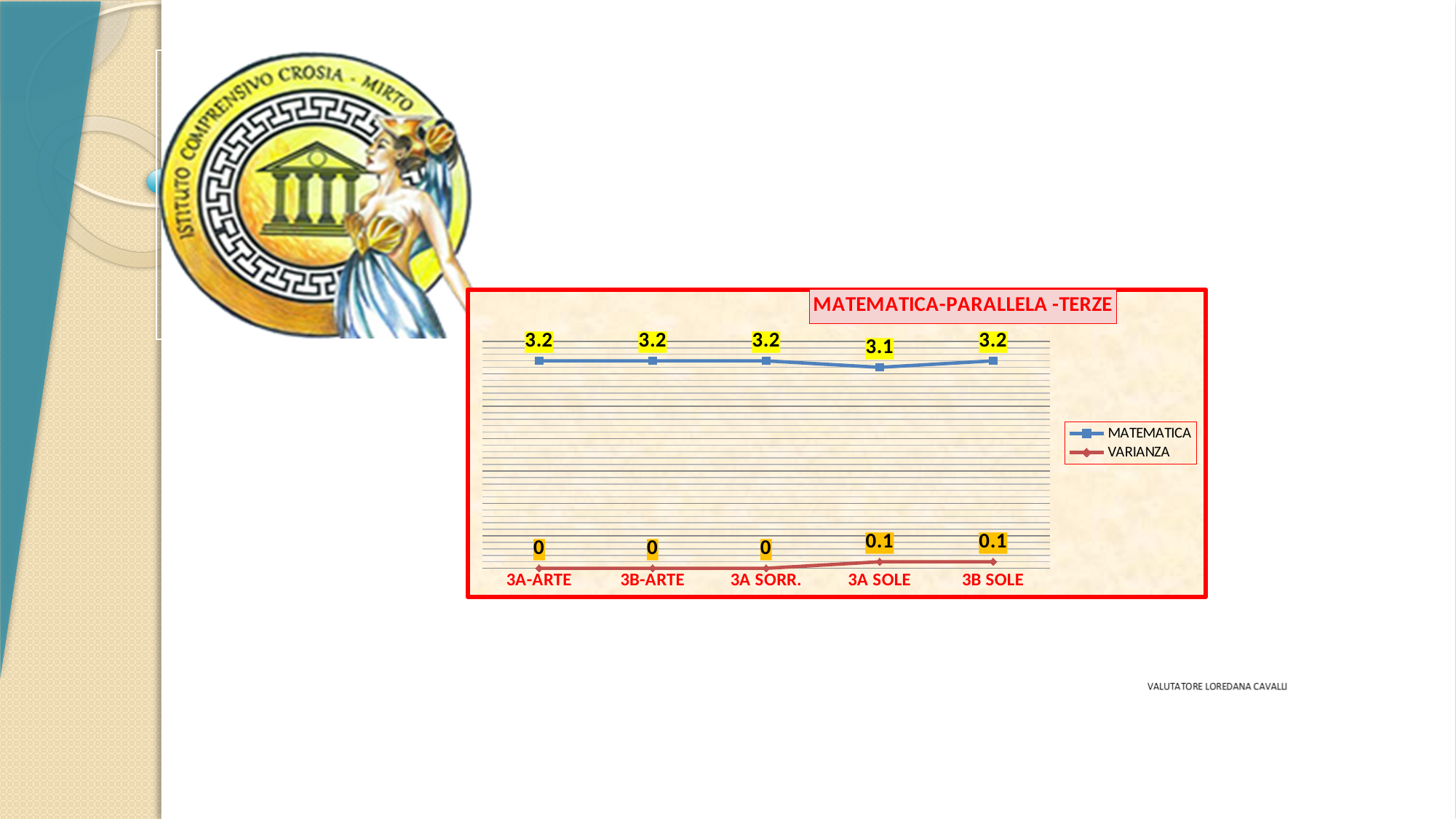
What is the difference between the MATEMATICA values for 3A-ARTE and 3A SOLE? 0.1 What is the title of the chart? MATEMATICA-PARALLELA -TERZE How many series does the legend list? 2 What kind of chart is shown? line chart What is the VARIANZA value for 3B SOLE? 0.1 Which is larger, the MATEMATICA value for 3A SORR. or for 3A SOLE? 3A SORR. What is the VARIANZA value for 3A SORR.? 0 What is the MATEMATICA value for 3B-ARTE? 3.2 How many categories are shown on the x axis? 5 Which category has the lowest MATEMATICA value? 3A SOLE What is the MATEMATICA value for 3A SOLE? 3.1 Which series is drawn in red? VARIANZA